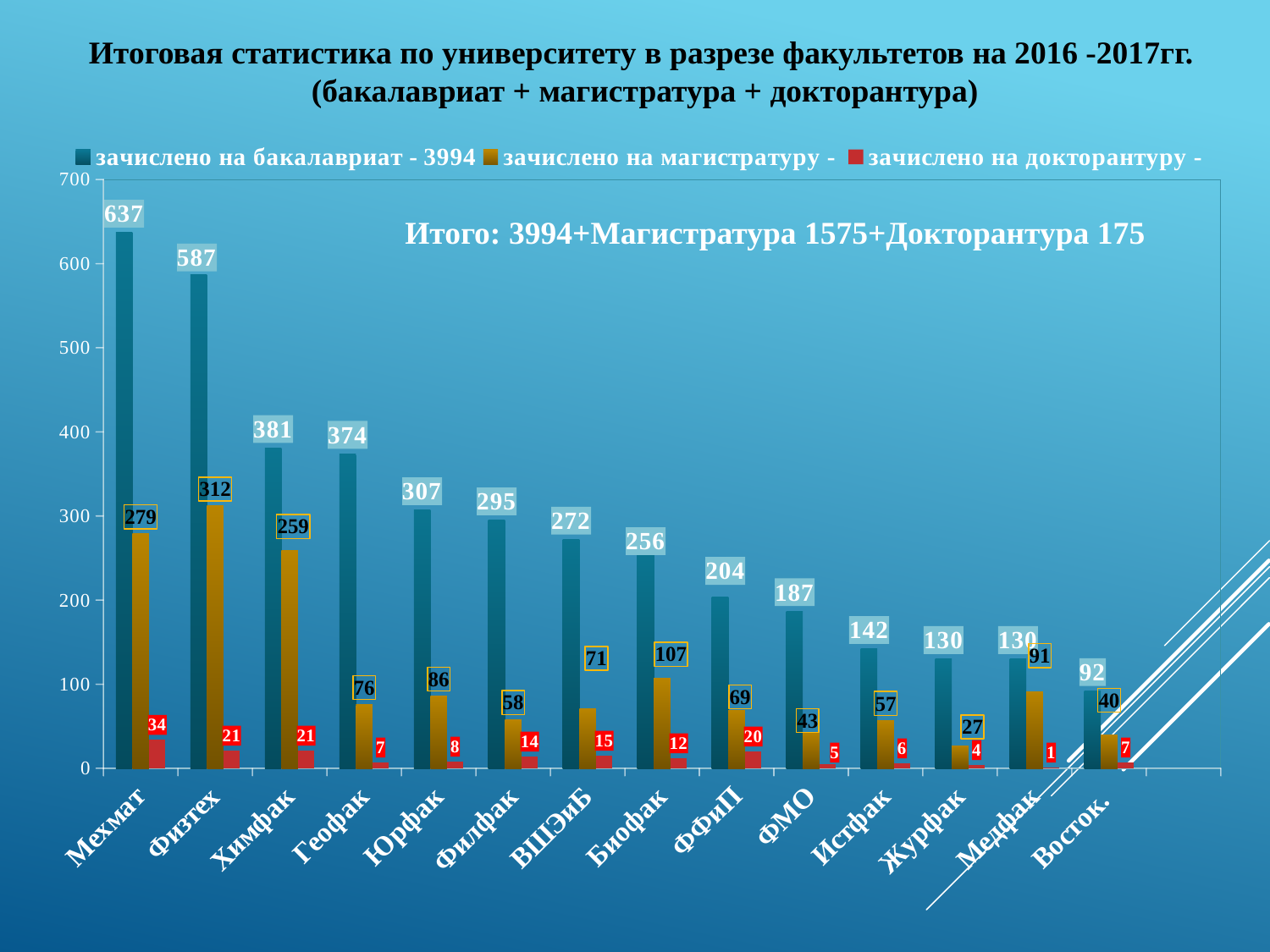
Which is larger: the master's enrolment (зачислено на магистратуру) at Мехмат or at Химфак? Мехмат How many series does the legend list? 3 What is the value for зачислено на магистратуру at Физтех? 312 What is the value for зачислено на докторантуру at ФФиП? 20 Which faculty has the highest value for зачислено на бакалавриат? Мехмат What kind of chart is shown on the slide? Bar chart How many faculties are shown on the x axis of the chart? 14 How many students were enrolled in the bachelor's programme (зачислено на бакалавриат) at Мехмат? 637 Do the values for зачислено на бакалавриат rise or fall from left to right along the x axis? Fall What is the difference between the bachelor's enrolment at Мехмат and at Физтех? 50 Which faculty has the highest value for зачислено на магистратуру? Физтех Which faculty has the lowest value for зачислено на докторантуру? Медфак